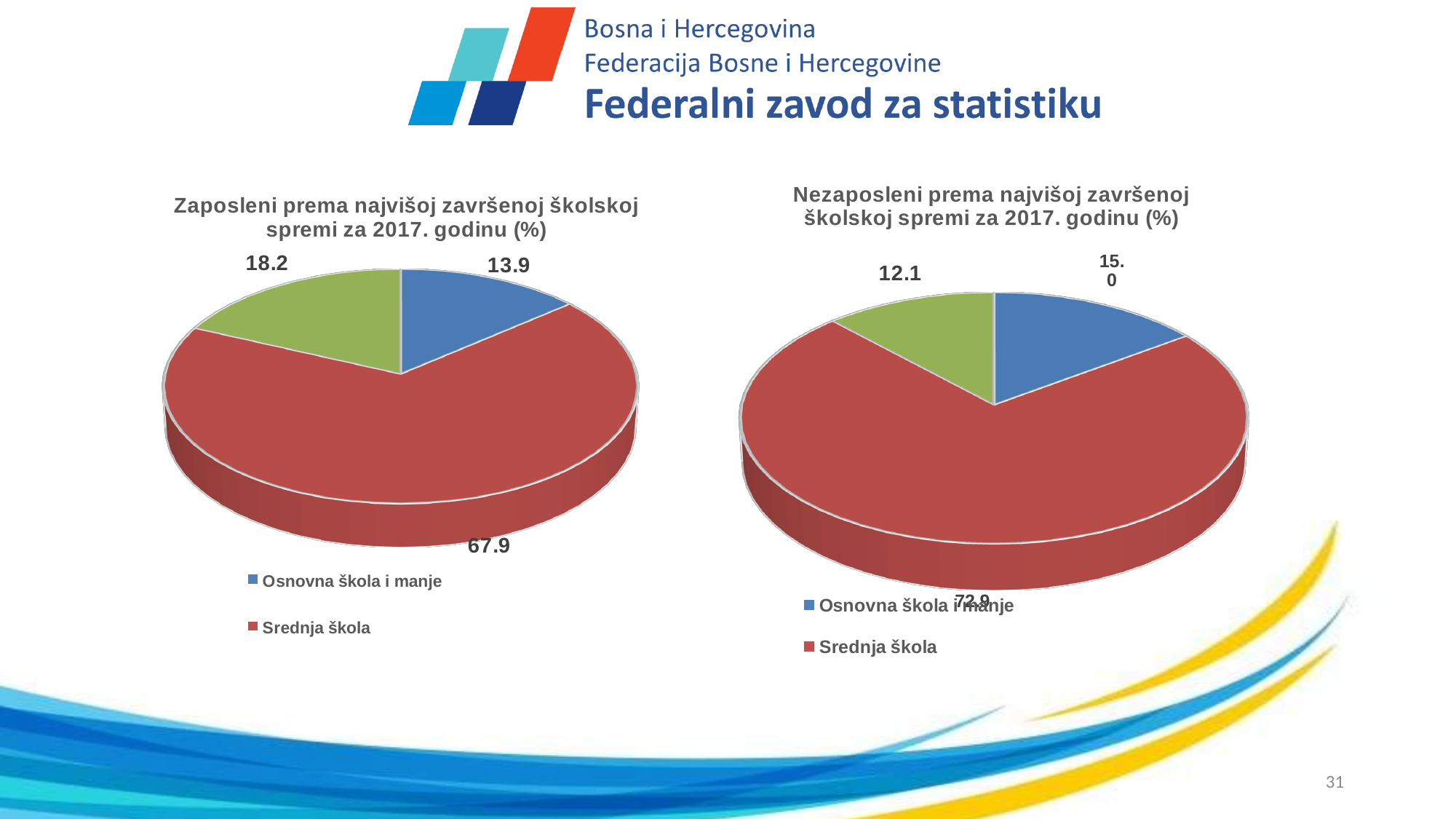
In the chart titled 'Nezaposleni prema najvišoj završenoj školskoj spremi za 2017. godinu (%)', what value is shown for Srednja škola? 72.9 In the chart titled 'Zaposleni prema najvišoj završenoj školskoj spremi za 2017. godinu (%)', what value is shown for Srednja škola? 67.9 What type of chart is used on this slide for the Zaposleni and Nezaposleni data? Pie chart In the chart titled 'Zaposleni prema najvišoj završenoj školskoj spremi za 2017. godinu (%)', what value is shown for Osnovna škola i manje? 13.9 In the chart titled 'Nezaposleni prema najvišoj završenoj školskoj spremi za 2017. godinu (%)', what value is shown for Osnovna škola i manje? 15.0 In the right chart (Nezaposleni), what is the difference between the values for Srednja škola and Osnovna škola i manje? 57.9 In the right chart (Nezaposleni), which category has the largest slice? Srednja škola In the left chart (Zaposleni), what is the difference between the values for Srednja škola and Osnovna škola i manje? 54.0 How many slices does the left chart (Zaposleni) have? 3 In the left chart (Zaposleni), which category has the largest slice? Srednja škola Is the value for Srednja škola larger in the Zaposleni chart or in the Nezaposleni chart? Nezaposleni chart Is the value for Osnovna škola i manje larger in the Zaposleni chart or in the Nezaposleni chart? Nezaposleni chart